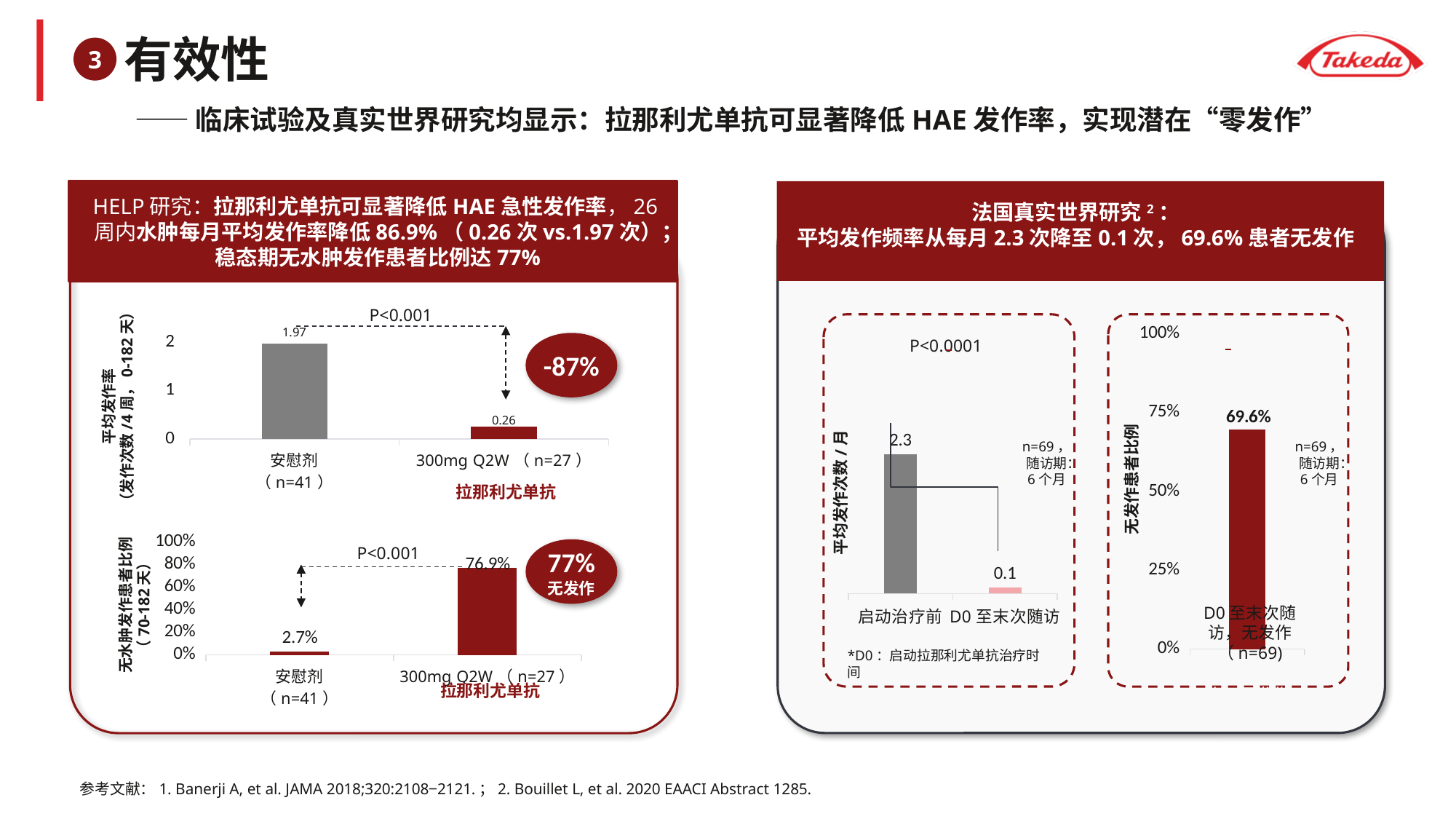
In the top-left chart (平均发作率, HELP study), what is the value for 300mg Q2W (n=27)? 0.26 In the far-right chart titled 无发作患者比例 (法国真实世界研究), what is the value for D0 至末次随访，无发作 (n=69)? 69.6% In the right-hand chart titled 平均发作次数/月 (法国真实世界研究), what is the value for 启动治疗前? 2.3 In the bottom-left chart (无水肿发作患者比例), what is the value for 300mg Q2W (n=27)? 76.9% In the bottom-left chart (无水肿发作患者比例), which category has the highest value? 300mg Q2W (n=27) What kind of chart is the top-left chart (平均发作率, HELP study)? bar chart In the top-left chart (平均发作率, HELP study), which category has the higher value, 安慰剂 or 300mg Q2W? 安慰剂 In the bottom-left chart (无水肿发作患者比例), what is the value for 安慰剂 (n=41)? 2.7% In the top-left chart (平均发作率, HELP study), what is the value for 安慰剂 (n=41)? 1.97 In the right-hand chart titled 平均发作次数/月 (法国真实世界研究), what is the value for D0 至末次随访? 0.1 In the top-left chart (平均发作率, HELP study), what is the difference between the 安慰剂 value and the 300mg Q2W value? 1.71 In the right-hand chart titled 平均发作次数/月 (法国真实世界研究), how many categories are plotted? 2